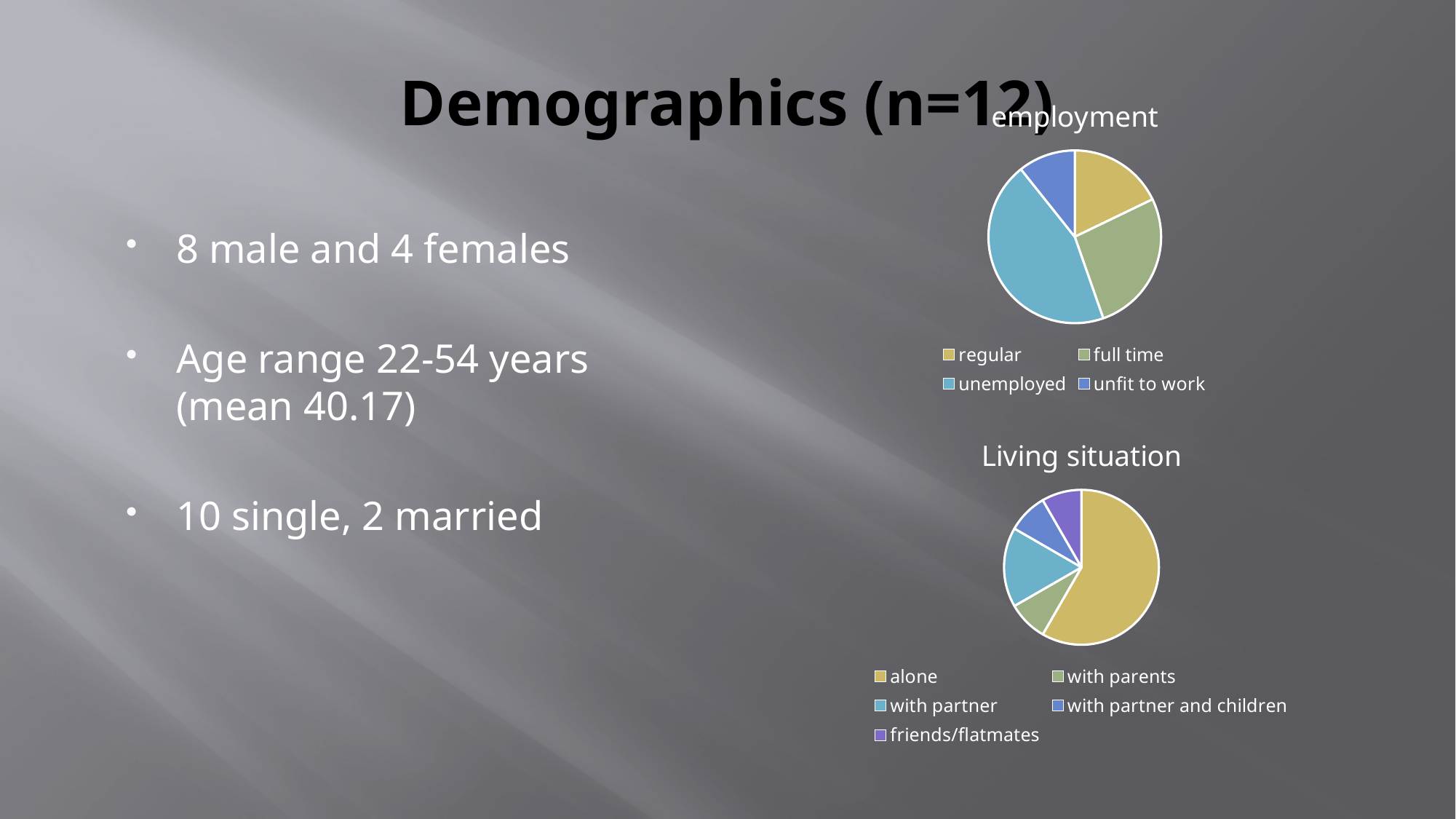
In the "employment" chart, which category has the smallest slice? unfit to work What kind of chart is the "Living situation" chart? pie chart What is the title of the lower pie chart on the slide? Living situation What kind of chart is the "employment" chart? pie chart In the "employment" chart, which slice is larger: full time or unfit to work? full time In the "employment" chart, how many categories does the legend list? 4 In the "employment" chart, which slice is larger: regular or unemployed? unemployed In the "employment" chart, which category has the largest slice? unemployed In the "Living situation" chart, which category has the largest slice? alone In the "Living situation" chart, what colour is the slice for "alone"? yellow In the "Living situation" chart, which slice is larger: alone or with partner? alone In the "Living situation" chart, how many categories does the legend list? 5